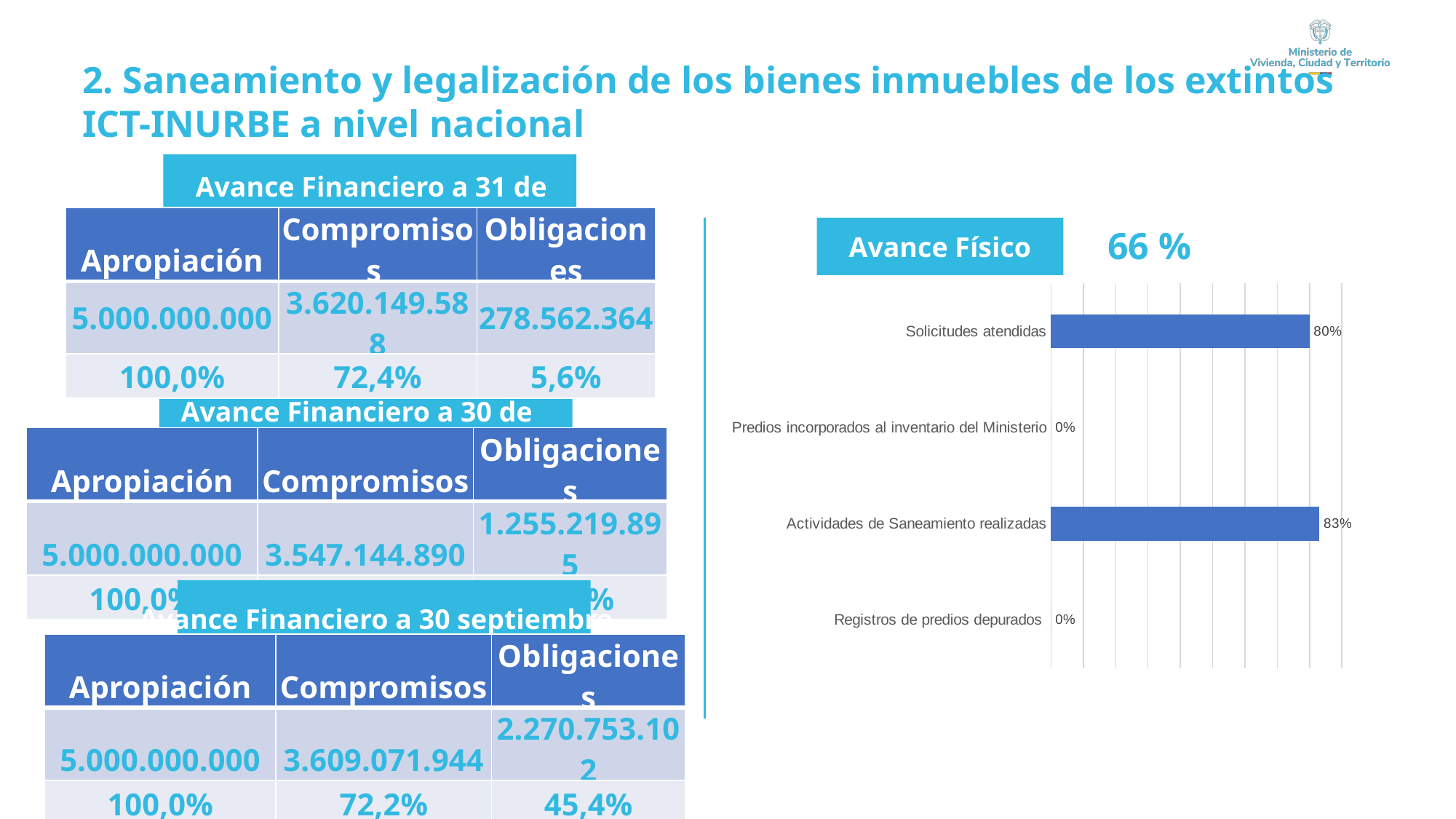
What is the value for Predios incorporados al inventario del Ministerio in the bar chart? 0% Which category has the highest value in the bar chart? Actividades de Saneamiento realizadas Which is larger in the bar chart: Solicitudes atendidas or Actividades de Saneamiento realizadas? Actividades de Saneamiento realizadas What is the overall Avance Físico percentage shown next to the chart heading? 66 % What is the value for Solicitudes atendidas in the bar chart? 80% What is the value for Actividades de Saneamiento realizadas in the bar chart? 83% How many categories in the bar chart have a value of 0%? 2 What is the value for Registros de predios depurados in the bar chart? 0% How many categories are shown in the bar chart? 4 What is the difference between the values for Solicitudes atendidas and Predios incorporados al inventario del Ministerio in the bar chart? 80% What is the difference between the values for Actividades de Saneamiento realizadas and Solicitudes atendidas in the bar chart? 3% What kind of chart is shown on the right side of the slide? Bar chart